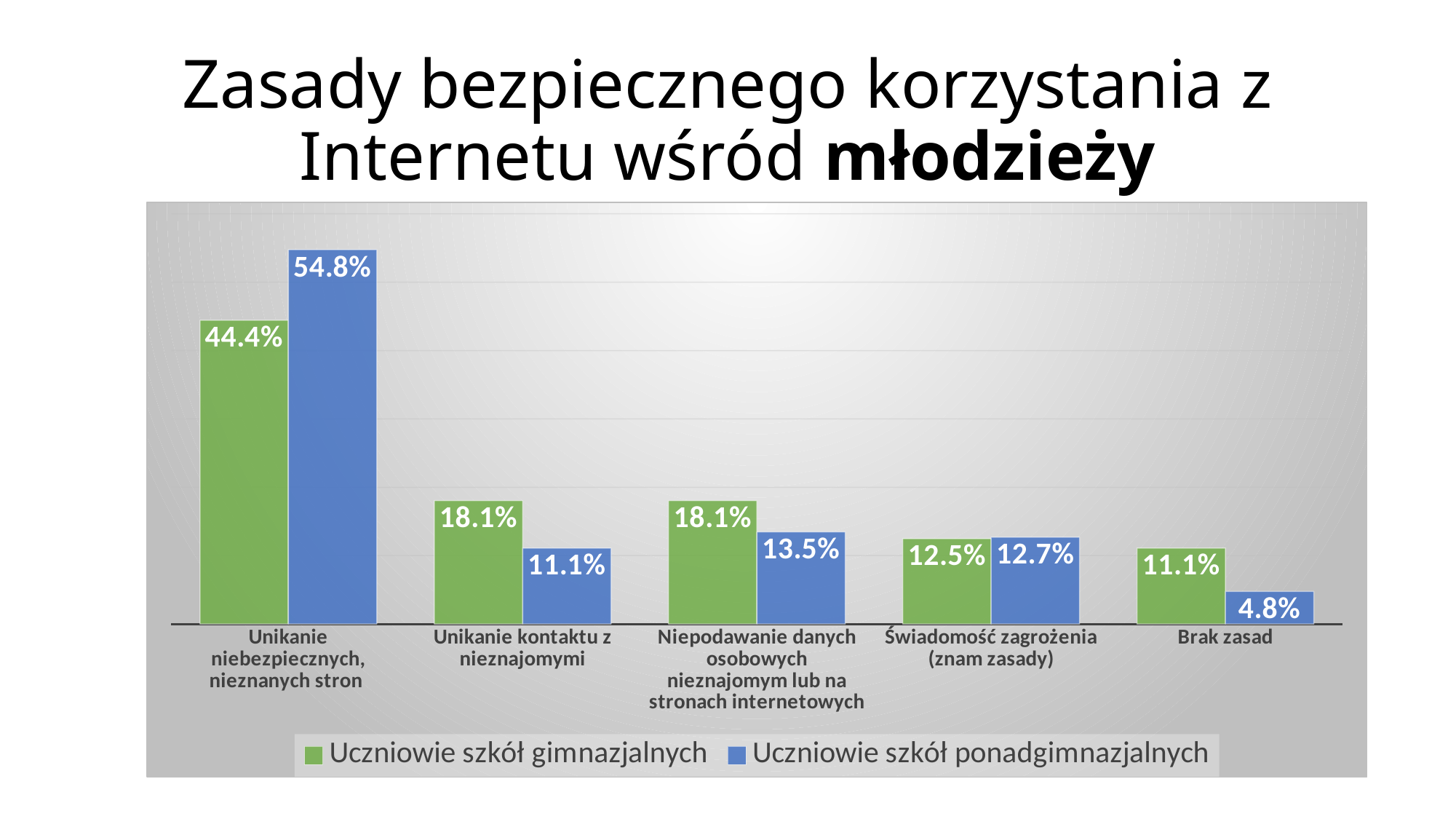
Which category has the highest value for "Uczniowie szkół gimnazjalnych"? Unikanie niebezpiecznych, nieznanych stron What value is shown for "Uczniowie szkół gimnazjalnych" in the category "Brak zasad"? 11.1% How many series does the chart's legend list? 2 What is the difference between the two series' values in the category "Brak zasad"? 6.3% What is the difference between the two series' values in the category "Unikanie niebezpiecznych, nieznanych stron"? 10.4% What value is shown for "Uczniowie szkół ponadgimnazjalnych" in the category "Unikanie niebezpiecznych, nieznanych stron"? 54.8% What value is shown for "Uczniowie szkół ponadgimnazjalnych" in the category "Niepodawanie danych osobowych nieznajomym lub na stronach internetowych"? 13.5% What value is shown for "Uczniowie szkół gimnazjalnych" in the category "Świadomość zagrożenia (znam zasady)"? 12.5% What kind of chart is shown on the slide? Bar chart In the category "Unikanie kontaktu z nieznajomymi", which series has the larger value? Uczniowie szkół gimnazjalnych Which category has the lowest value for "Uczniowie szkół ponadgimnazjalnych"? Brak zasad How many categories are shown on the x axis of the chart? 5